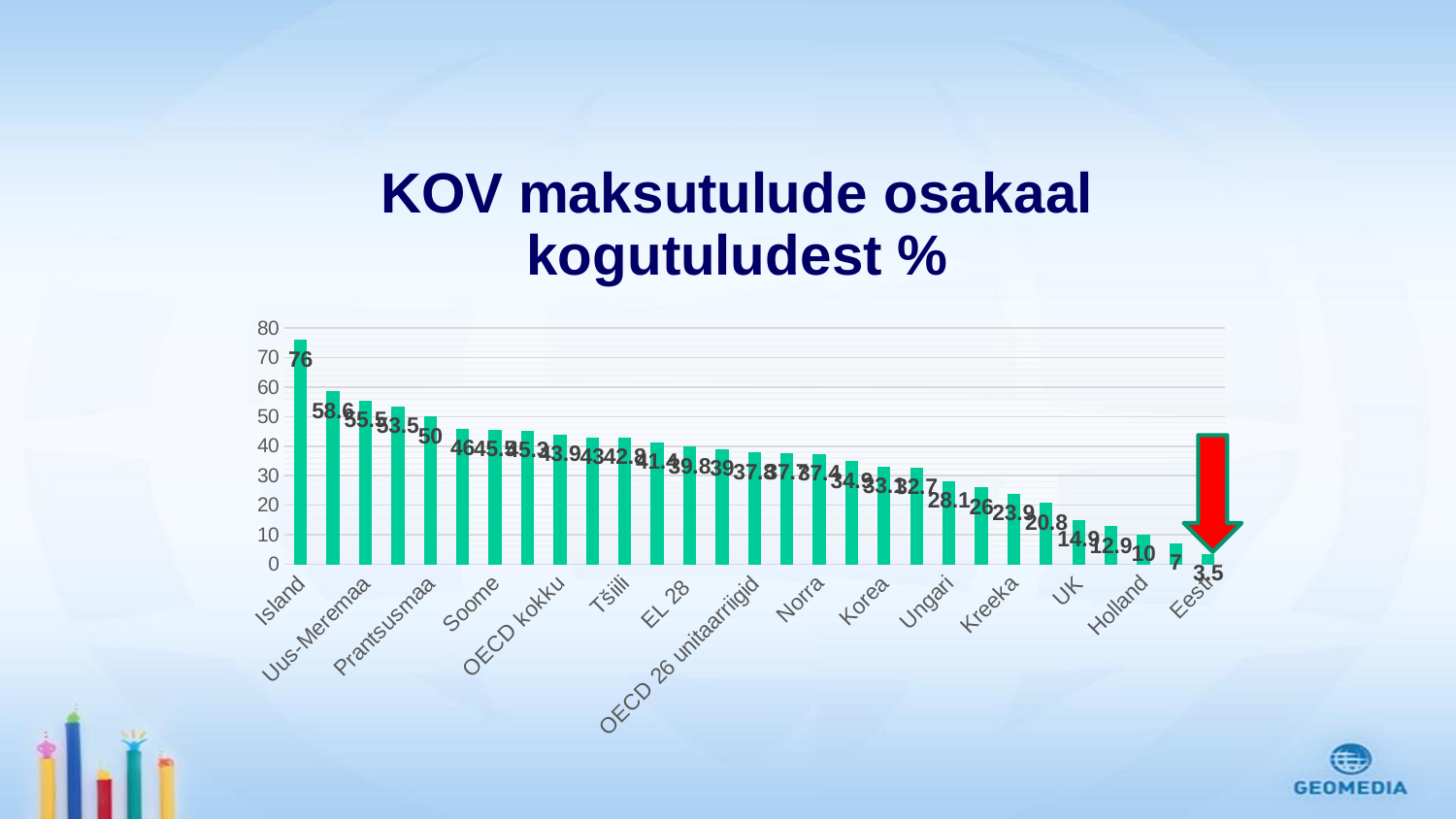
What is the title of the chart? KOV maksutulude osakaal kogutuludest % Which category has the lowest value? Eesti Do the values rise or fall from left to right along the x axis? fall What is the value for Island? 76 What is the difference between the values for Island and Eesti? 72.5 What type of chart is shown on the slide? bar chart Is the value for Prantsusmaa greater or less than 40? greater Which is larger, the value for Island or the value for Eesti? Island Which category is marked with a red arrow on the chart? Eesti Is the value for Kreeka greater or less than 30? less What is the value for Eesti? 3.5 Which category has the highest value? Island